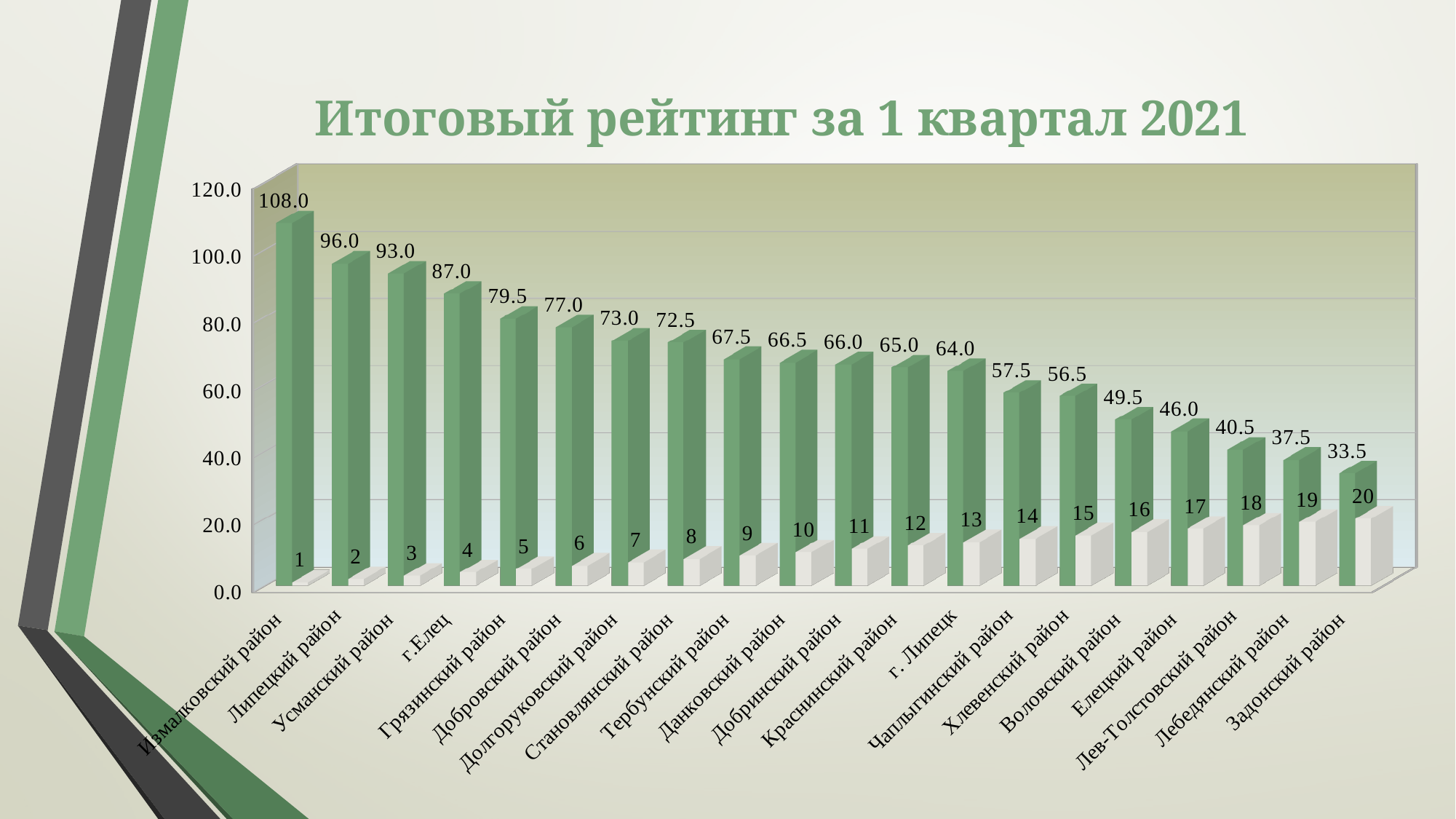
What is the value for г. Липецк? 64.0 Which district has the lowest value? Задонский район Do the values rise or fall from left to right along the x axis? Fall Which district has the highest value? Измалковский район How many districts are shown on the chart? 20 What is the difference between the values for Измалковский район and Задонский район? 74.5 What is the difference between the values for Липецкий район and Усманский район? 3.0 What is the value for Воловский район? 49.5 What is the title of the chart? Итоговый рейтинг за 1 квартал 2021 What kind of chart is shown on the slide? Bar chart What is the value for Измалковский район? 108.0 Which is larger, the value for Грязинский район or the value for Хлевенский район? Грязинский район